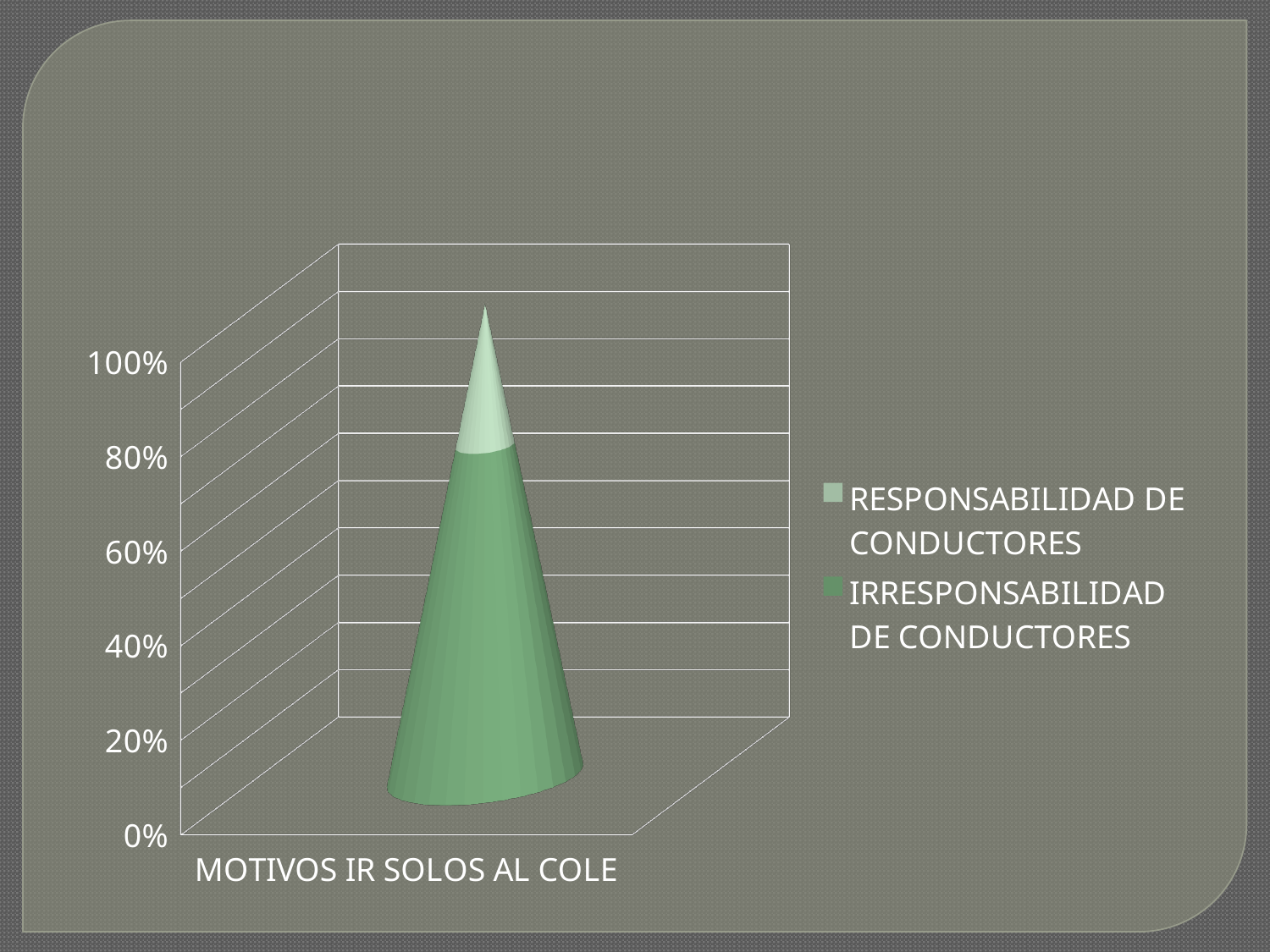
Which series has the smallest segment in the stacked bar? RESPONSABILIDAD DE CONDUCTORES Which series has the largest segment in the stacked bar? IRRESPONSABILIDAD DE CONDUCTORES How many categories are shown on the x axis? 1 What kind of chart is shown on the slide? bar chart How many series does the legend list? 2 Which series is shown at the bottom of the stacked bar? IRRESPONSABILIDAD DE CONDUCTORES Is the value for RESPONSABILIDAD DE CONDUCTORES greater or less than 40%? less What is the highest value shown on the vertical axis? 100% Which series takes up the larger share of the stacked bar, RESPONSABILIDAD DE CONDUCTORES or IRRESPONSABILIDAD DE CONDUCTORES? IRRESPONSABILIDAD DE CONDUCTORES What is the label of the category on the x axis? MOTIVOS IR SOLOS AL COLE Is the value for IRRESPONSABILIDAD DE CONDUCTORES greater or less than 60%? greater